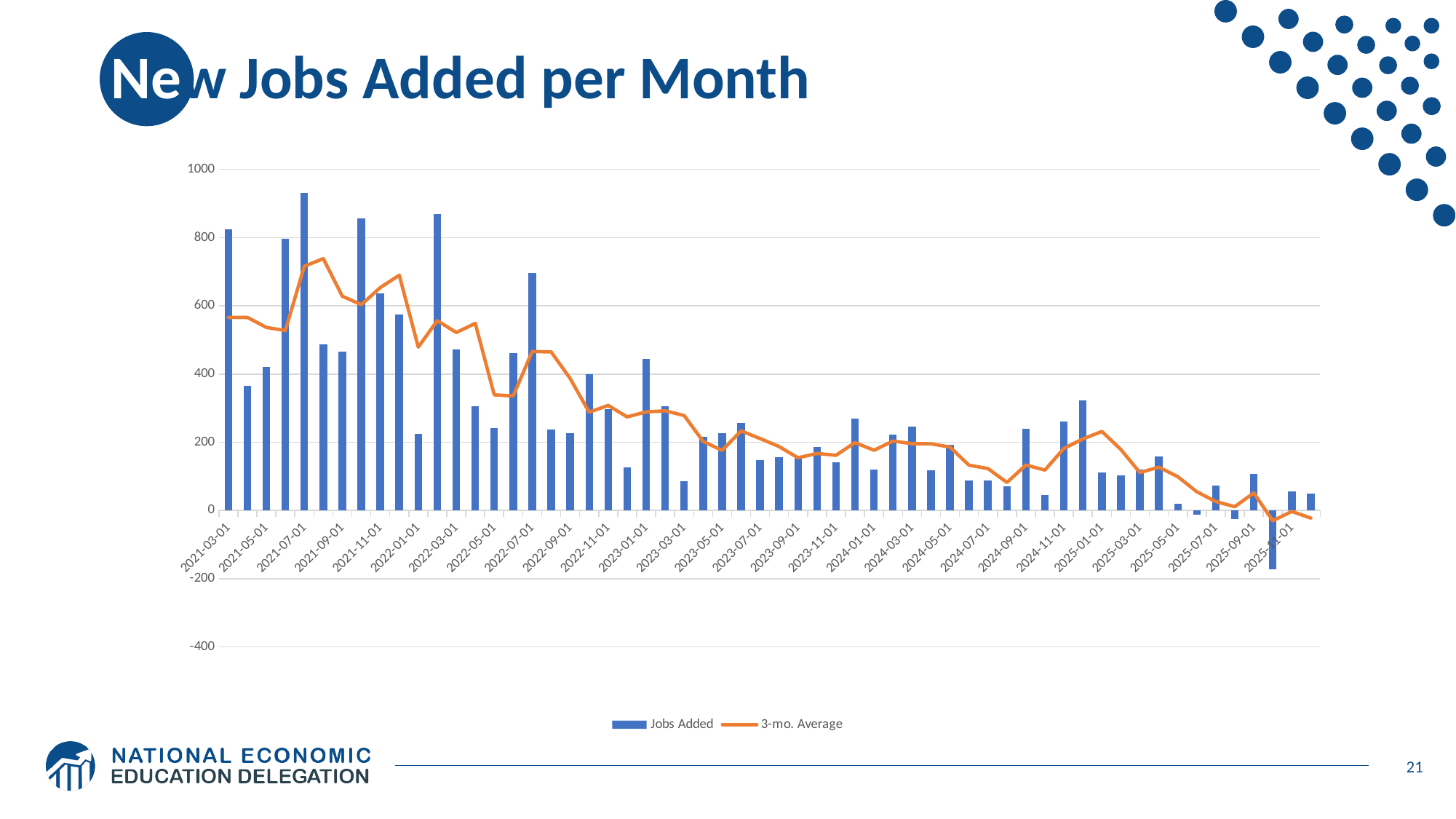
Is the Jobs Added value for 2025-01-01 greater or less than 200? less Is the 3-mo. Average value at 2021-07-01 greater or less than 600? greater Do the Jobs Added values generally rise or fall from 2021 to 2025? fall Which month has the highest Jobs Added bar? 2021-07-01 Is the Jobs Added value for 2024-01-01 greater or less than 200? less What are the two series named in the legend? Jobs Added and 3-mo. Average Which is larger, the Jobs Added value for 2021-03-01 or for 2025-01-01? 2021-03-01 What is the title of the chart? New Jobs Added per Month How many series does the legend list? 2 What kind of chart is shown on the slide? A bar chart with a line overlay